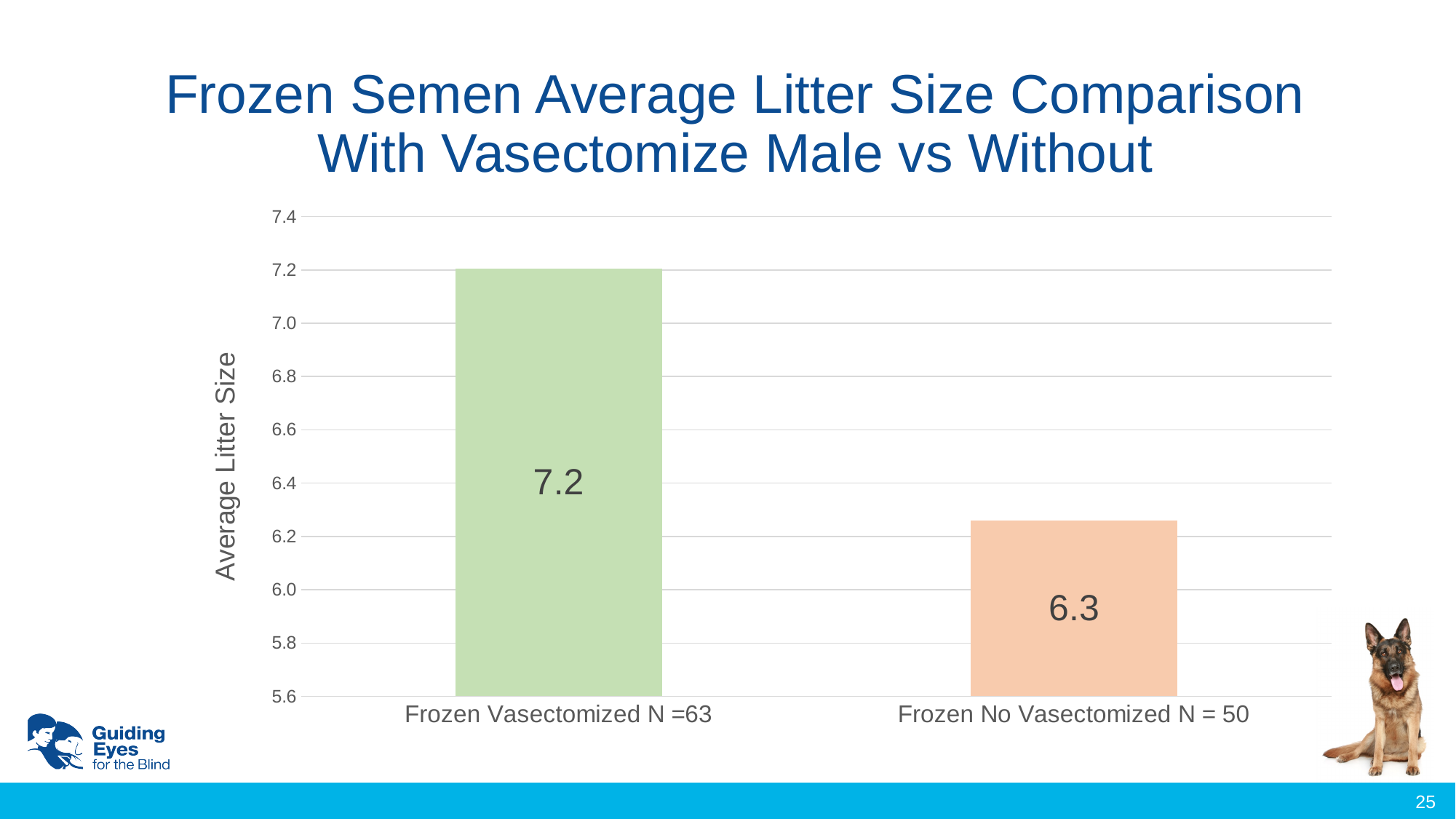
Is the value for Frozen Vasectomized N =63 greater or less than 7.0? greater What is the difference in average litter size between Frozen Vasectomized N =63 and Frozen No Vasectomized N = 50? 0.9 Which category has the lower average litter size? Frozen No Vasectomized N = 50 What is the title of the slide? Frozen Semen Average Litter Size Comparison With Vasectomize Male vs Without What is the average litter size for Frozen Vasectomized N =63? 7.2 How many categories are shown in the chart? 2 What kind of chart is shown on the slide? Bar chart What is the label of the vertical axis? Average Litter Size Which category has the higher average litter size? Frozen Vasectomized N =63 What is the average litter size for Frozen No Vasectomized N = 50? 6.3 Is the value for Frozen No Vasectomized N = 50 greater or less than 7.0? less Is the average litter size larger for Frozen Vasectomized N =63 or Frozen No Vasectomized N = 50? Frozen Vasectomized N =63